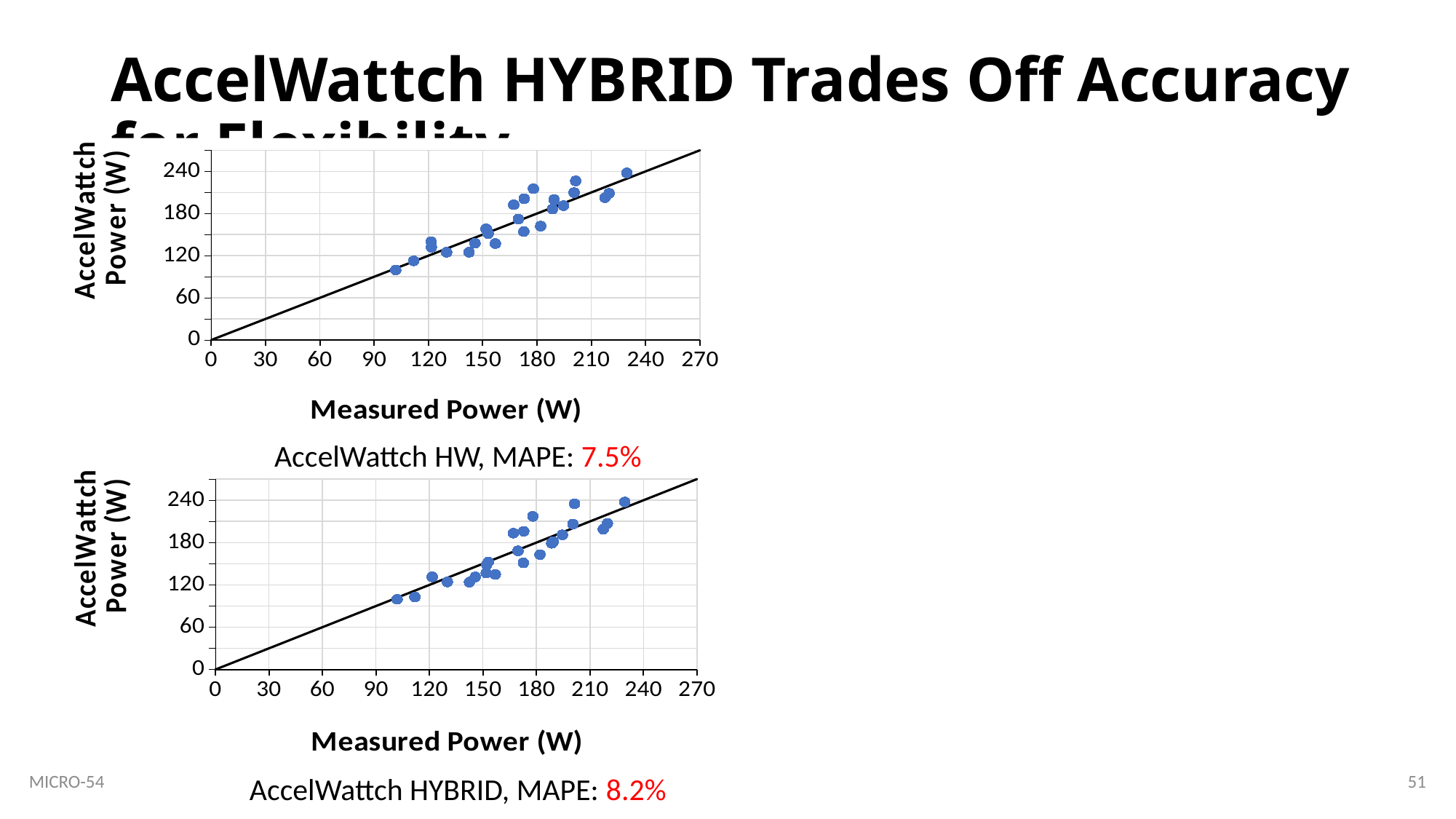
In the top chart (AccelWattch HW), is the smallest plotted Measured Power value greater or less than 90? greater In the bottom chart (AccelWattch HYBRID), is the highest plotted AccelWattch Power value greater or less than 180? greater In the bottom chart (AccelWattch HYBRID), do the plotted AccelWattch Power values rise or fall as Measured Power increases? rise What MAPE is reported for AccelWattch HW under the top chart? 7.5% What kind of chart is the top chart on the slide? scatter chart In the bottom chart (AccelWattch HYBRID), is the lowest plotted AccelWattch Power value greater or less than 120? less What MAPE is reported for AccelWattch HYBRID under the bottom chart? 8.2% What kind of chart is the bottom chart on the slide? scatter chart In the top chart (AccelWattch HW), do the plotted AccelWattch Power values rise or fall as Measured Power increases? rise